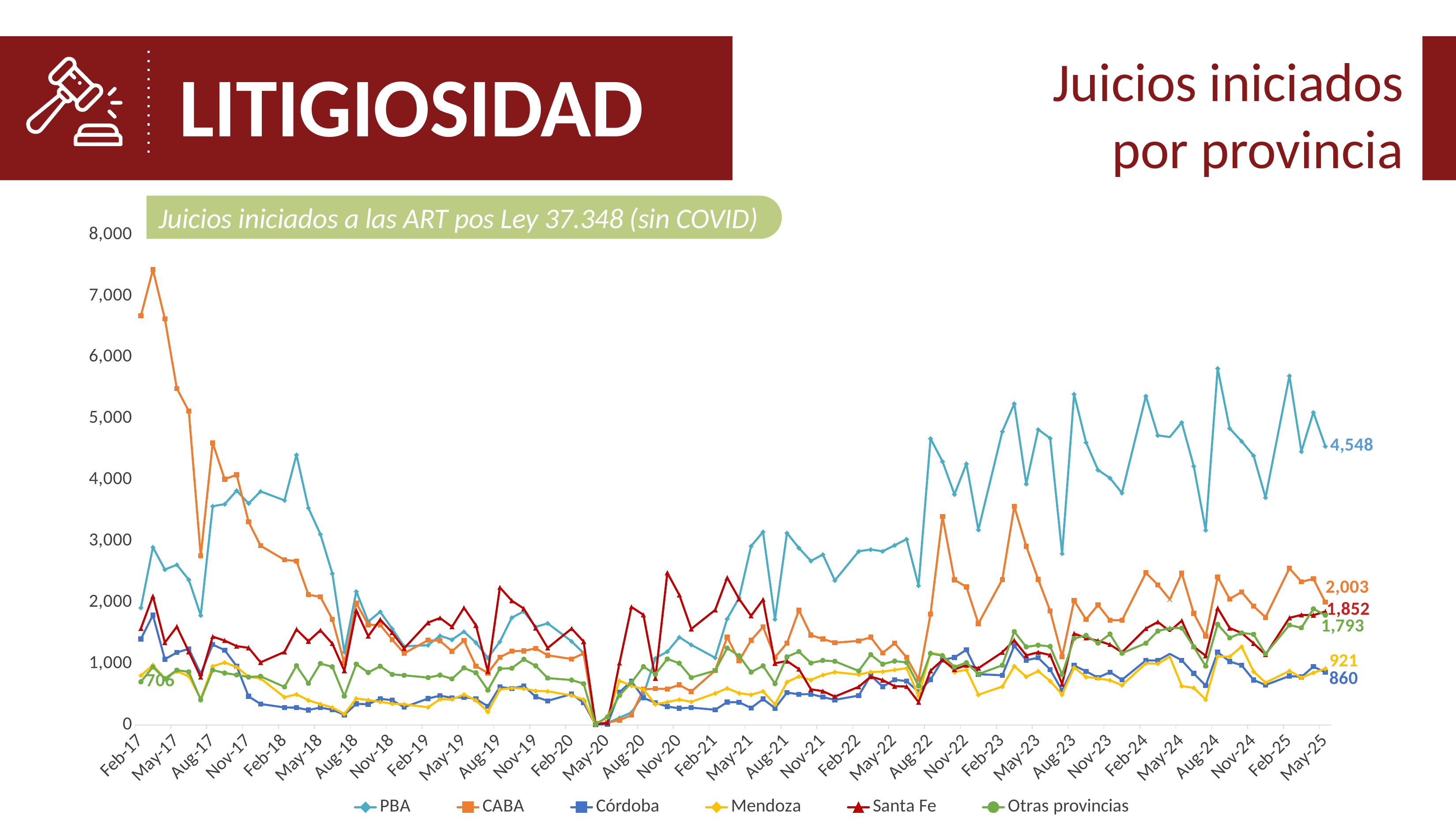
What is the title of the chart? Juicios iniciados a las ART pos Ley 37.348 (sin COVID) How many series does the legend list? 6 What is the value for Santa Fe at May-25? 1,852 At May-25, which is larger: Mendoza or Córdoba? Mendoza What is the value for Córdoba at May-25? 860 What kind of chart is shown on the slide? line chart What is the value for CABA at May-25? 2,003 Which series has the lowest value at May-25? Córdoba What is the difference between the PBA and CABA values at May-25? 2,545 What is the value for PBA at May-25? 4,548 Is the value for CABA at Feb-17 greater or less than 6,000? greater Which series has the highest value at May-25? PBA